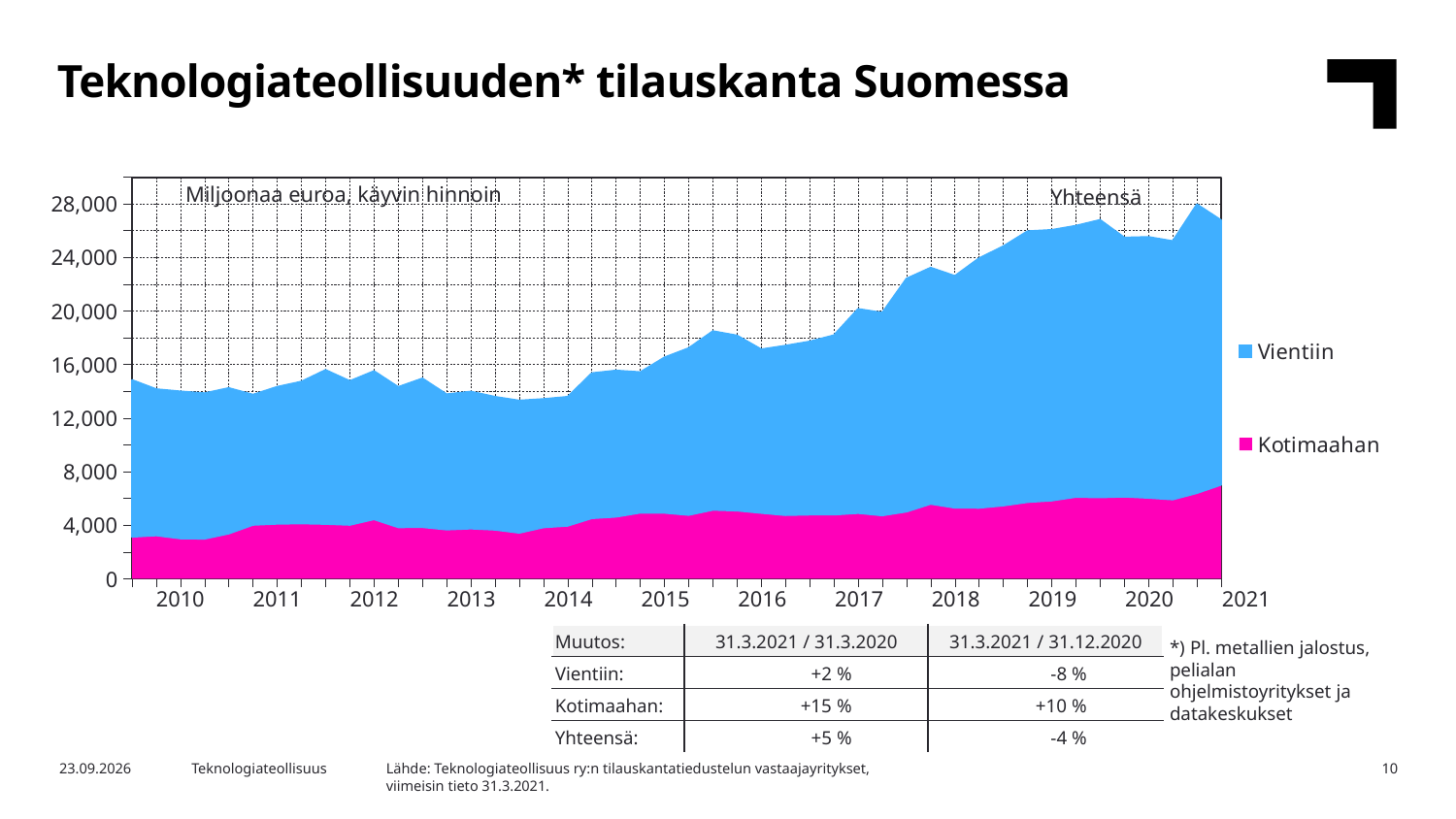
What unit label is printed inside the chart area at the top left? Miljoonaa euroa, käyvin hinnoin Is the value for Kotimaahan at the start of 2010 greater or less than 4,000? less What kind of chart is shown on the slide? Stacked area chart Which two series are listed in the chart's legend? Vientiin and Kotimaahan Is the total (Yhteensä) at the start of 2010 greater or less than 20,000? less Which series is larger throughout the chart, Vientiin or Kotimaahan? Vientiin Is the value for Kotimaahan at the end of the series in 2021 greater or less than 4,000? greater How many series does the chart's legend list? 2 Does the total order book (Yhteensä) rise or fall overall from 2010 to 2021? rise How many years are labelled on the x axis of the chart? 12